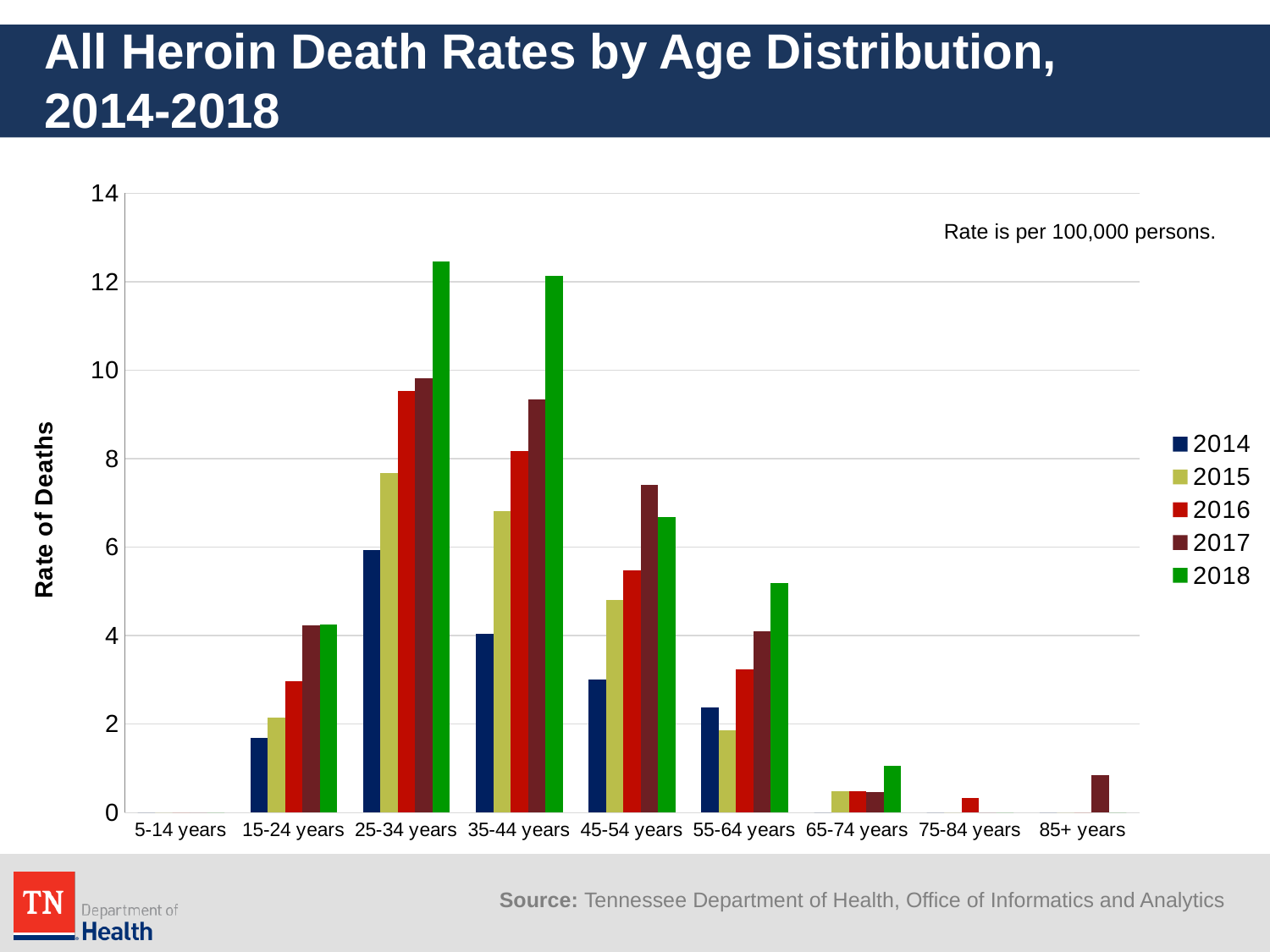
For 2014, which is larger, the value for 25-34 years or for 35-44 years? 25-34 years Is the 2018 value for 25-34 years greater or less than 12? greater For the 25-34 years group, do the values rise or fall from 2014 to 2018? rise For the 45-54 years group, which is larger, the 2017 value or the 2018 value? 2017 How many age groups are shown on the x axis? 9 How many series does the legend list? 5 What kind of chart is shown on the slide? bar chart What is the title of the y axis? Rate of Deaths Is the 2017 value for 45-54 years greater or less than 6? greater Is the 2018 value for 55-64 years greater or less than 4? greater Among the 15-24 years bars, which year has the lowest value? 2014 Which age group has the highest 2018 heroin death rate? 25-34 years